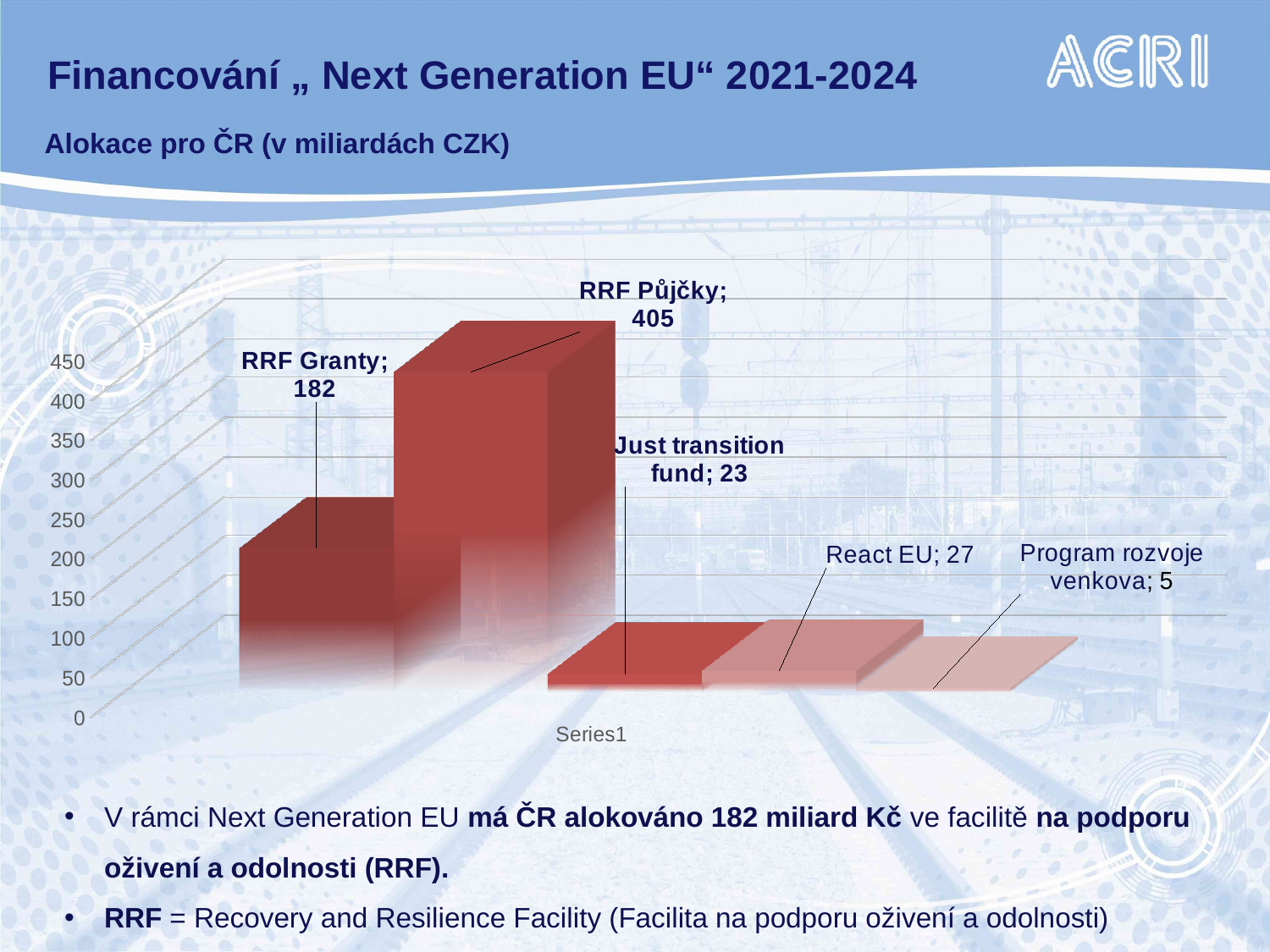
Which is larger, the value for React EU or the value for Just transition fund? React EU What value is shown for Program rozvoje venkova? 5 What value is shown for RRF Granty? 182 How many categories are plotted in the chart? 5 Which category has the lowest value? Program rozvoje venkova What is the highest value shown on the vertical axis? 450 What value is shown for RRF Půjčky? 405 What value is shown for React EU? 27 What kind of chart is shown on the slide? bar chart Which category has the highest value? RRF Půjčky What value is shown for Just transition fund? 23 What is the difference between the values for RRF Půjčky and RRF Granty? 223